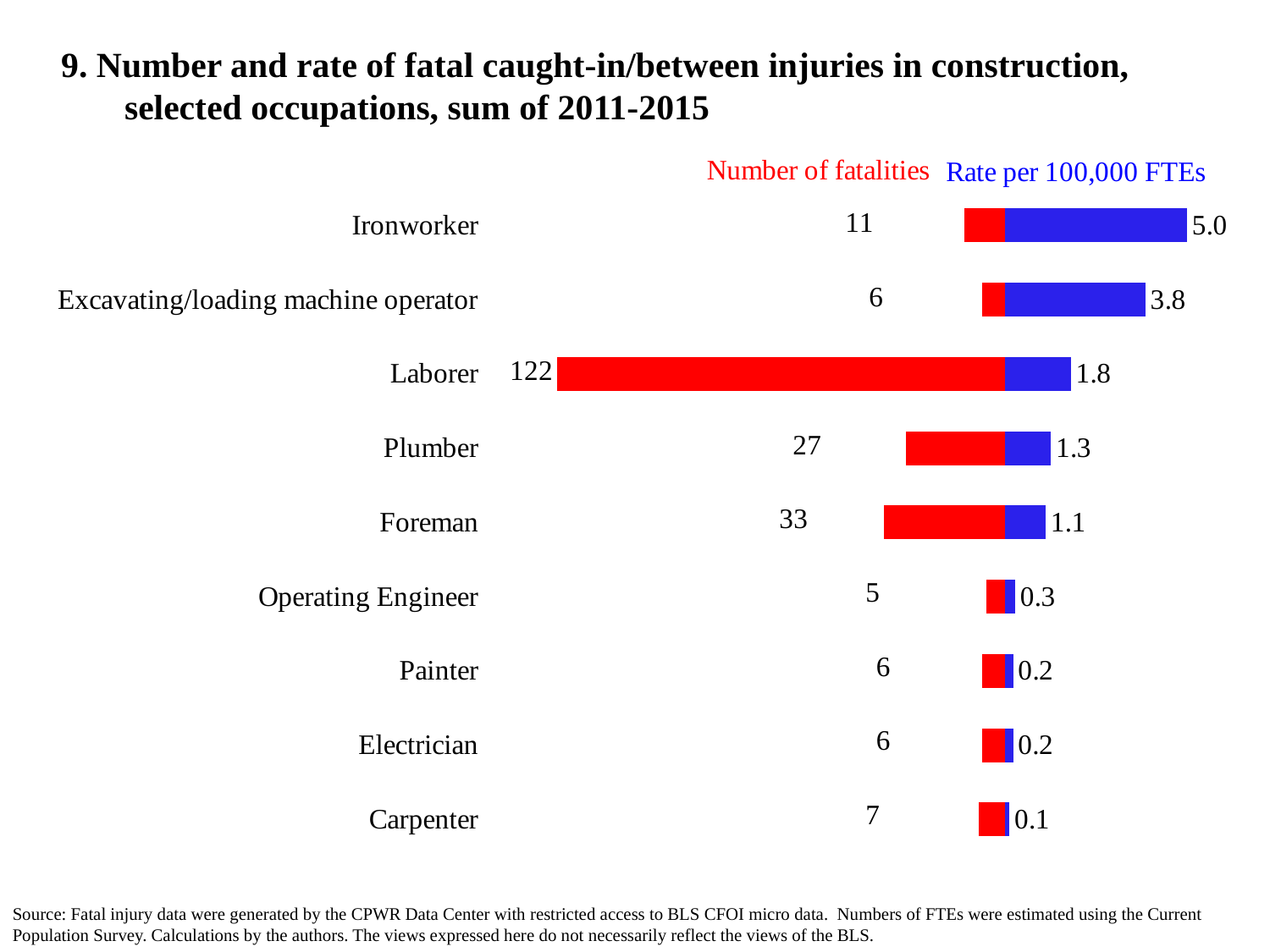
Which has more fatalities, Plumber or Foreman? Foreman How many fatalities are shown for Foreman? 33 Which occupation has the highest rate per 100,000 FTEs? Ironworker What is the rate per 100,000 FTEs for Excavating/loading machine operator? 3.8 What is the rate per 100,000 FTEs for Ironworker? 5.0 How many occupations are shown in the chart? 9 Which occupation has the lowest rate per 100,000 FTEs? Carpenter What type of chart is shown on the slide? Bar chart Which occupation has the highest number of fatalities? Laborer What is the difference in number of fatalities between Laborer and Foreman? 89 How many fatalities are shown for Laborer? 122 What is the difference in rate per 100,000 FTEs between Ironworker and Plumber? 3.7